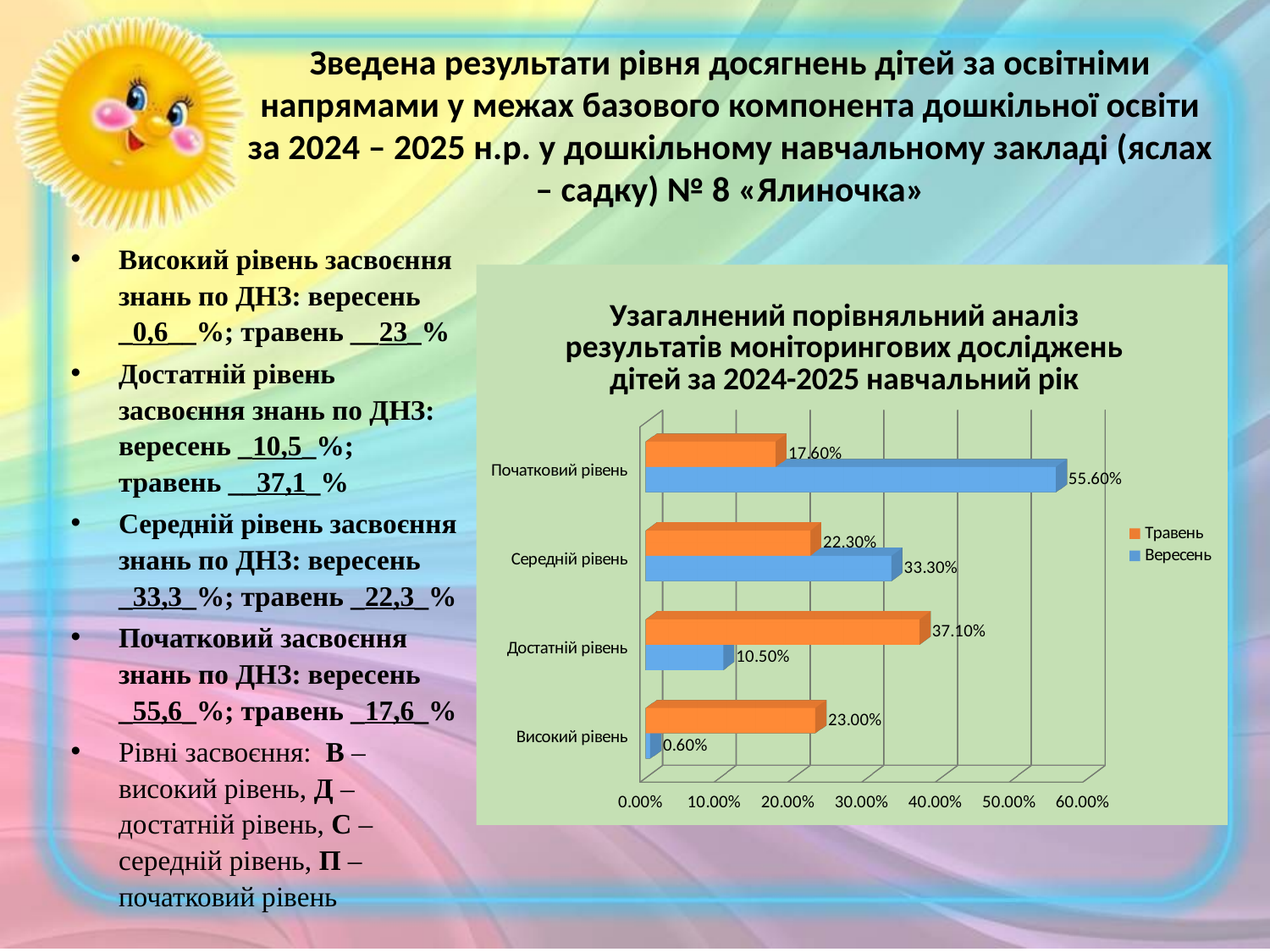
Which is larger for Достатній рівень: the Травень value or the Вересень value? Травень What type of chart is shown on the slide? bar chart Which colour represents the Вересень series in the chart? blue What is the difference between the Вересень and Травень values for Початковий рівень? 38.00% How many series does the legend list? 2 What is the value for Вересень in the Високий рівень category? 0.60% What is the value for Травень in the Достатній рівень category? 37.10% What is the value for Травень in the Середній рівень category? 22.30% What is the value for Вересень in the Початковий рівень category? 55.60% How many categories are plotted on the chart? 4 Which category has the lowest value for the Травень series? Початковий рівень Which category has the highest value for the Вересень series? Початковий рівень